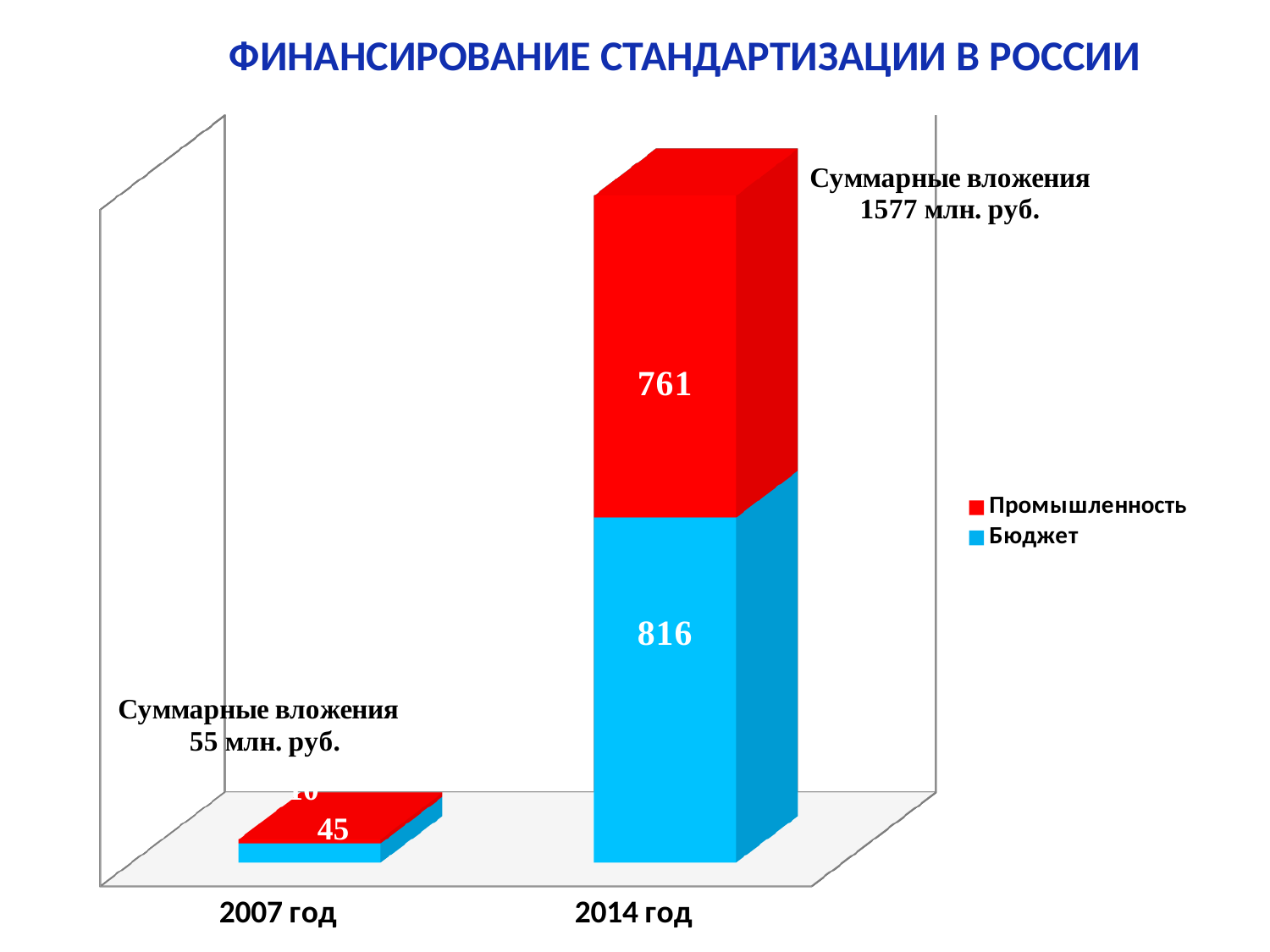
What is the difference between Бюджет and Промышленность in 2014 год? 55 What kind of chart is shown on the slide? Stacked bar chart What colour represents Промышленность in the legend? Red What are the total investments (Суммарные вложения) shown for 2014 год? 1577 млн. руб. Do the total investments rise or fall from 2007 год to 2014 год? Rise How many categories (years) are shown on the x axis? 2 What are the total investments (Суммарные вложения) shown for 2007 год? 55 млн. руб. What is the value for Бюджет in 2014 год? 816 What is the value for Бюджет in 2007 год? 45 What is the value for Промышленность in 2014 год? 761 How many series does the legend list? 2 In 2014 год, which is larger: Бюджет or Промышленность? Бюджет